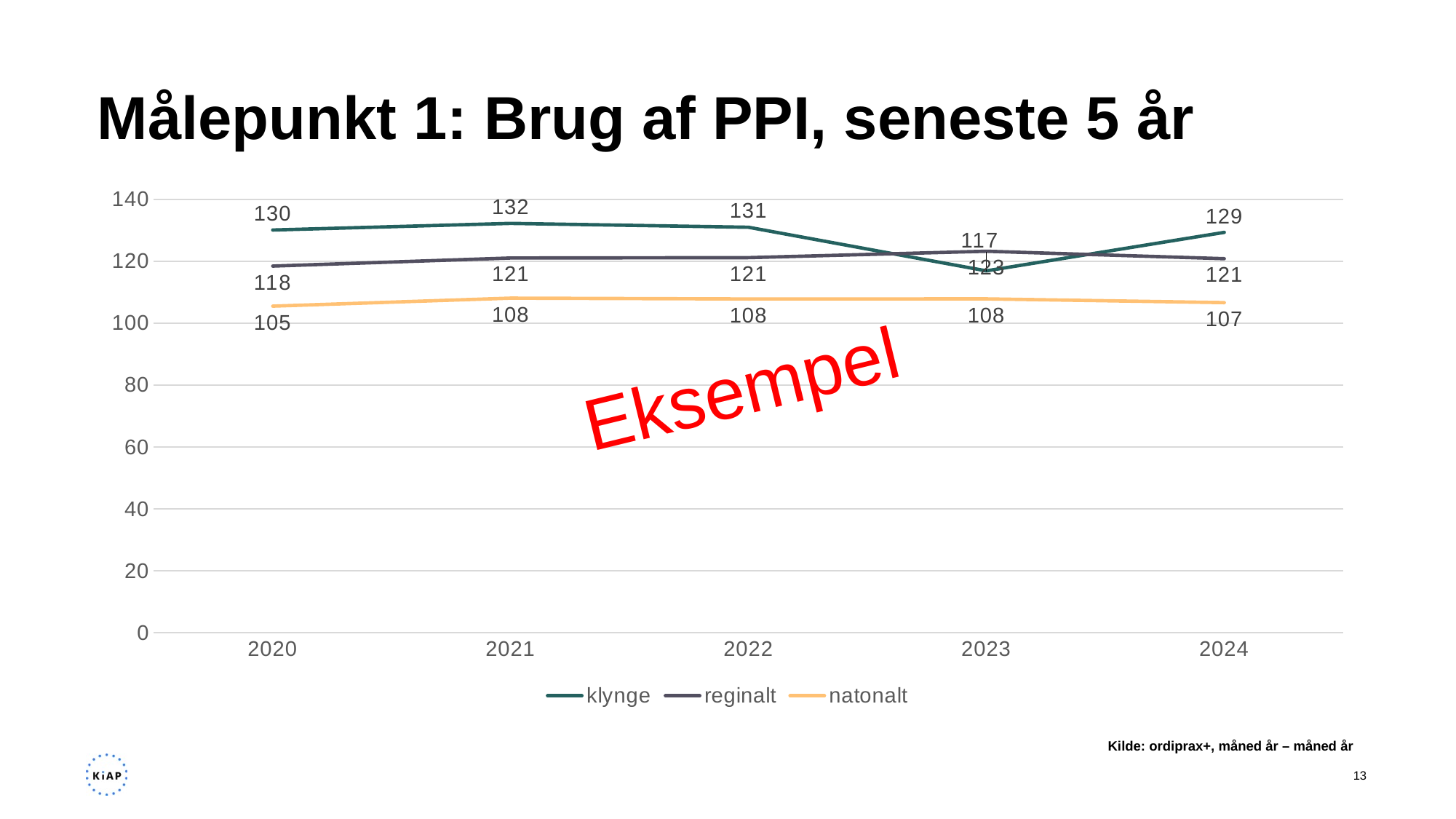
How many years are plotted on the x axis? 5 What kind of chart is shown on the slide? line chart Which is larger in 2020, the klynge value or the reginalt value? klynge What is the title of the chart slide? Målepunkt 1: Brug af PPI, seneste 5 år How many series does the legend list? 3 What is the value for klynge in 2023? 117 What is the difference between the klynge and natonalt values in 2024? 22 In which year is the klynge value lowest? 2023 In which year is the klynge value highest? 2021 What is the value for natonalt in 2020? 105 What is the value for klynge in 2021? 132 What is the value for reginalt in 2022? 121